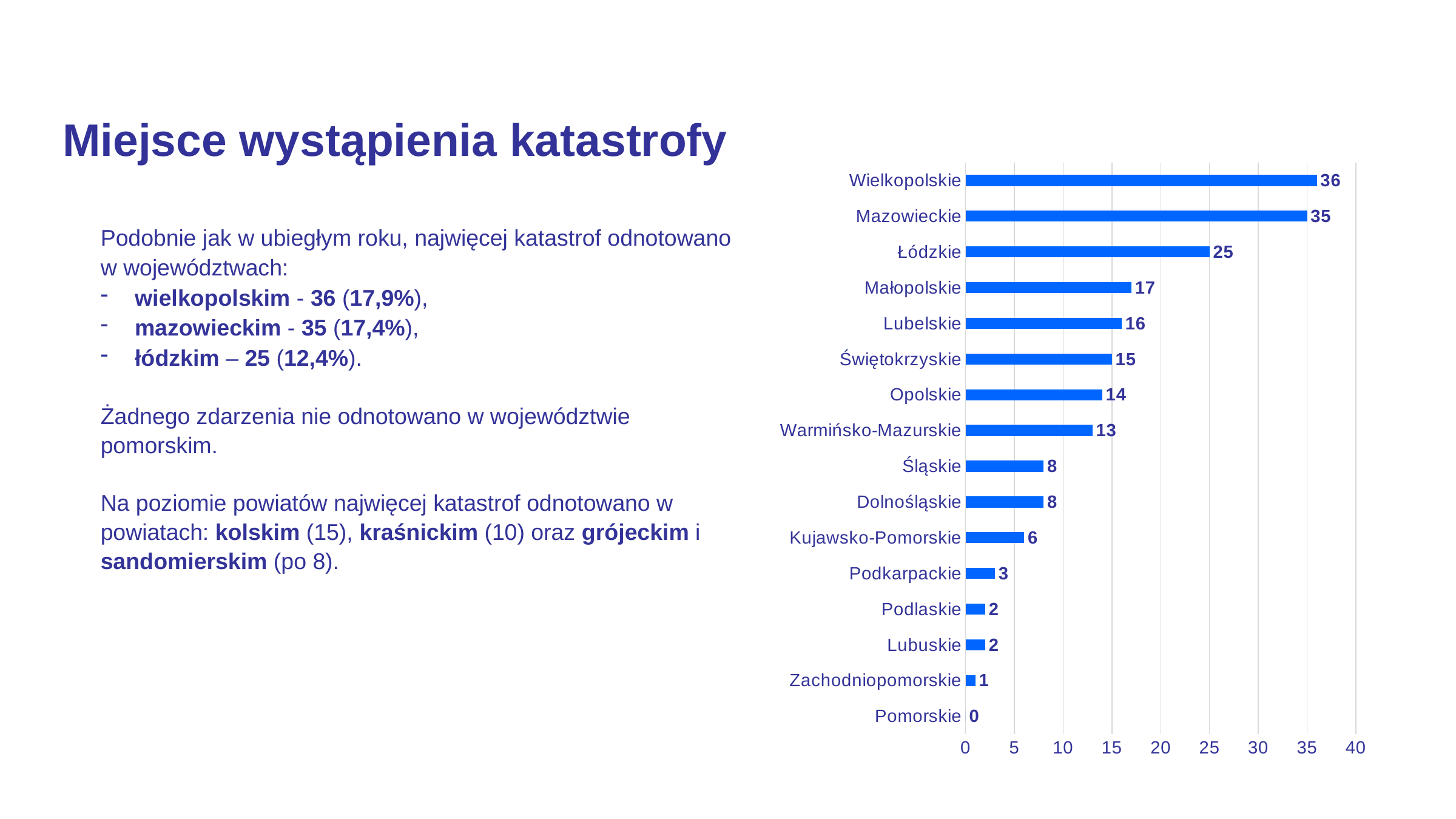
Which is larger, the value for Lubelskie or the value for Opolskie? Lubelskie What is the value for Łódzkie? 25 What kind of chart is shown on the slide? bar chart What is the difference between the values for Wielkopolskie and Mazowieckie? 1 What is the highest value shown on the horizontal axis of the chart? 40 Which category has the highest value? Wielkopolskie Is the value for Łódzkie greater or less than 20? greater What is the value for Warmińsko-Mazurskie? 13 How many categories are shown on the chart? 16 What is the difference between the values for Małopolskie and Kujawsko-Pomorskie? 11 What is the value for Wielkopolskie? 36 Which category has the lowest value? Pomorskie